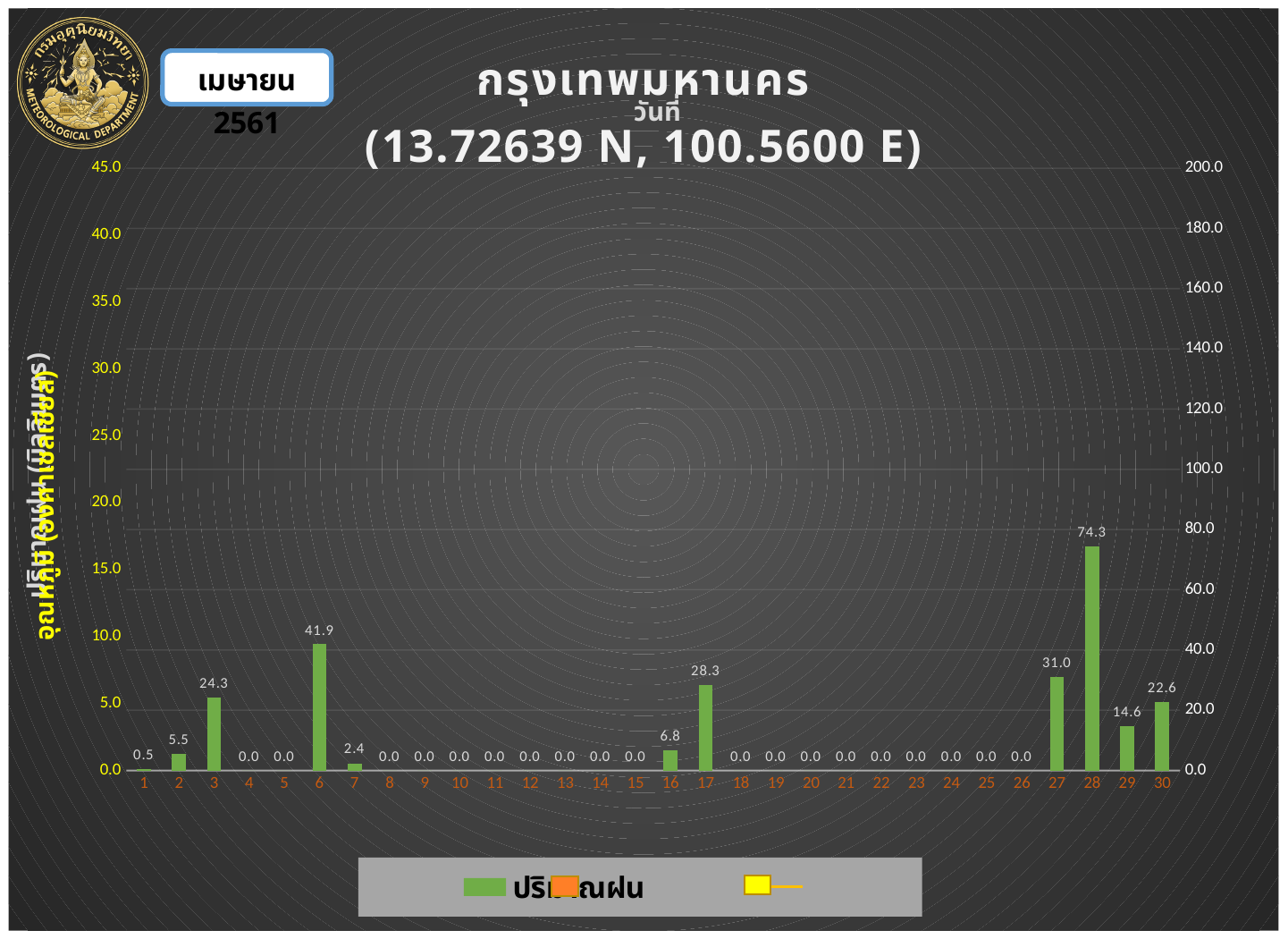
What is the value labelled on the bar for day 17? 28.3 What is the value labelled on the bar for day 7? 2.4 What is the value labelled on the bar for day 3? 24.3 Which day has the highest bar in the chart? 28 What is the rainfall value shown for day 28? 74.3 Which is larger, the value for day 2 or the value for day 16? day 16 How many days are shown on the x axis of the chart? 30 What is the difference between the values for day 6 and day 17? 13.6 What is the difference between the values for day 28 and day 27? 43.3 What is the value labelled on the bar for day 6? 41.9 What kind of chart is shown on the slide? bar chart Which is larger, the value for day 29 or the value for day 30? day 30